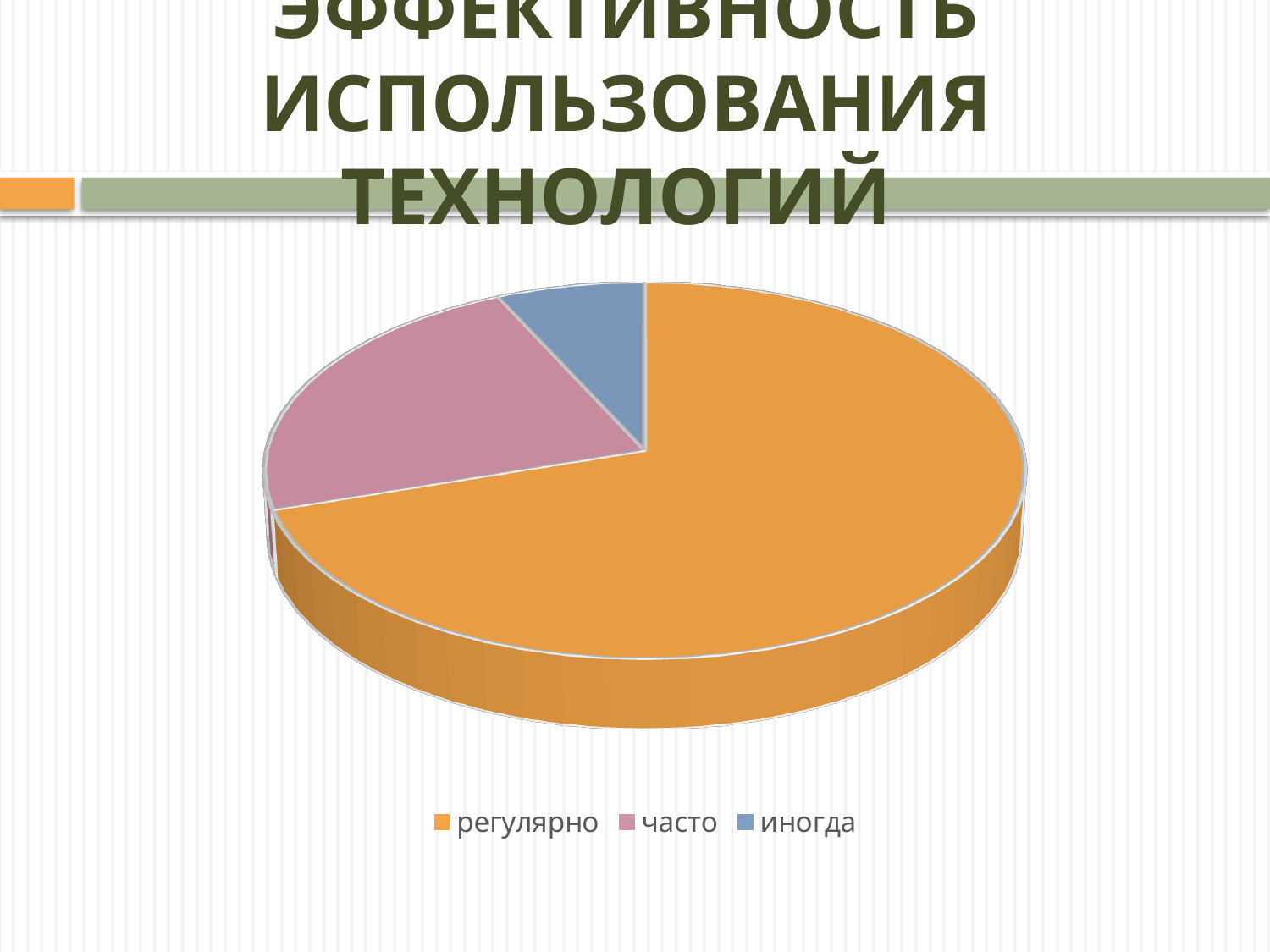
How many slices does the pie chart have? 3 What is the title of the slide containing the chart? ЭФФЕКТИВНОСТЬ ИСПОЛЬЗОВАНИЯ ТЕХНОЛОГИЙ Does the регулярно slice take up more or less than half of the pie? more What colour is the slice for иногда? blue Which slice is larger, регулярно or часто? регулярно How many entries does the legend list? 3 Which slice is larger, часто or иногда? часто What kind of chart is shown on the slide? pie chart Which category has the smallest slice of the pie? иногда Which category has the largest slice of the pie? регулярно